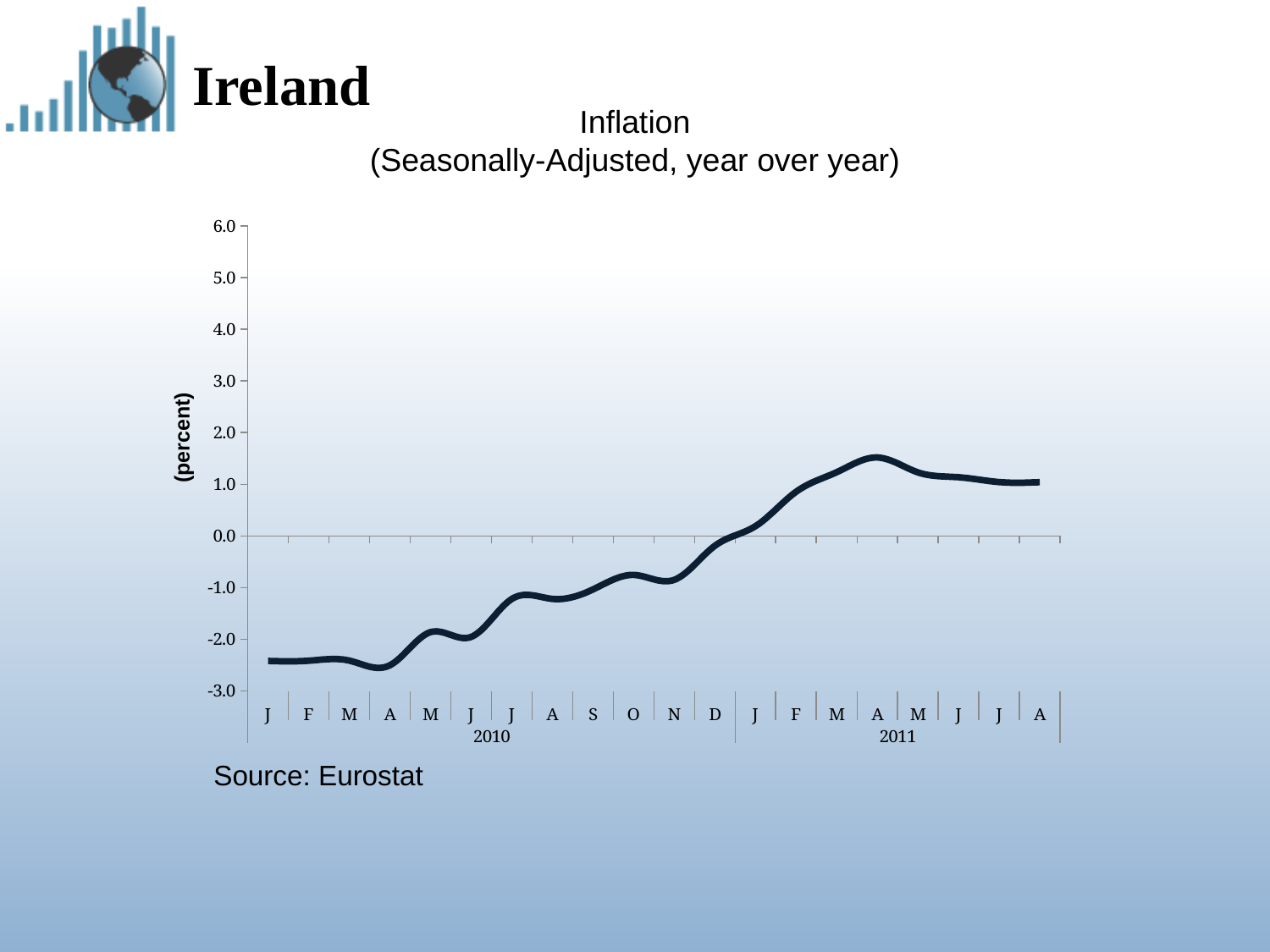
Overall, does the inflation line rise or fall from January 2010 to August 2011? Rise Which is larger, the inflation value for April 2011 or for August 2011? April 2011 How many monthly data points are plotted on the chart? 20 Is the inflation value for October 2010 greater or less than -1.0? greater What kind of chart is shown on the slide? Line chart What is the title of the chart? Inflation (Seasonally-Adjusted, year over year) Which is larger, the inflation value for January 2010 or for August 2011? August 2011 Is the inflation value for January 2010 greater or less than -2.0? less What is the label on the vertical axis of the chart? (percent) Is the inflation value for April 2011 greater or less than 1.0? greater In which month does the inflation line reach its highest value? April 2011